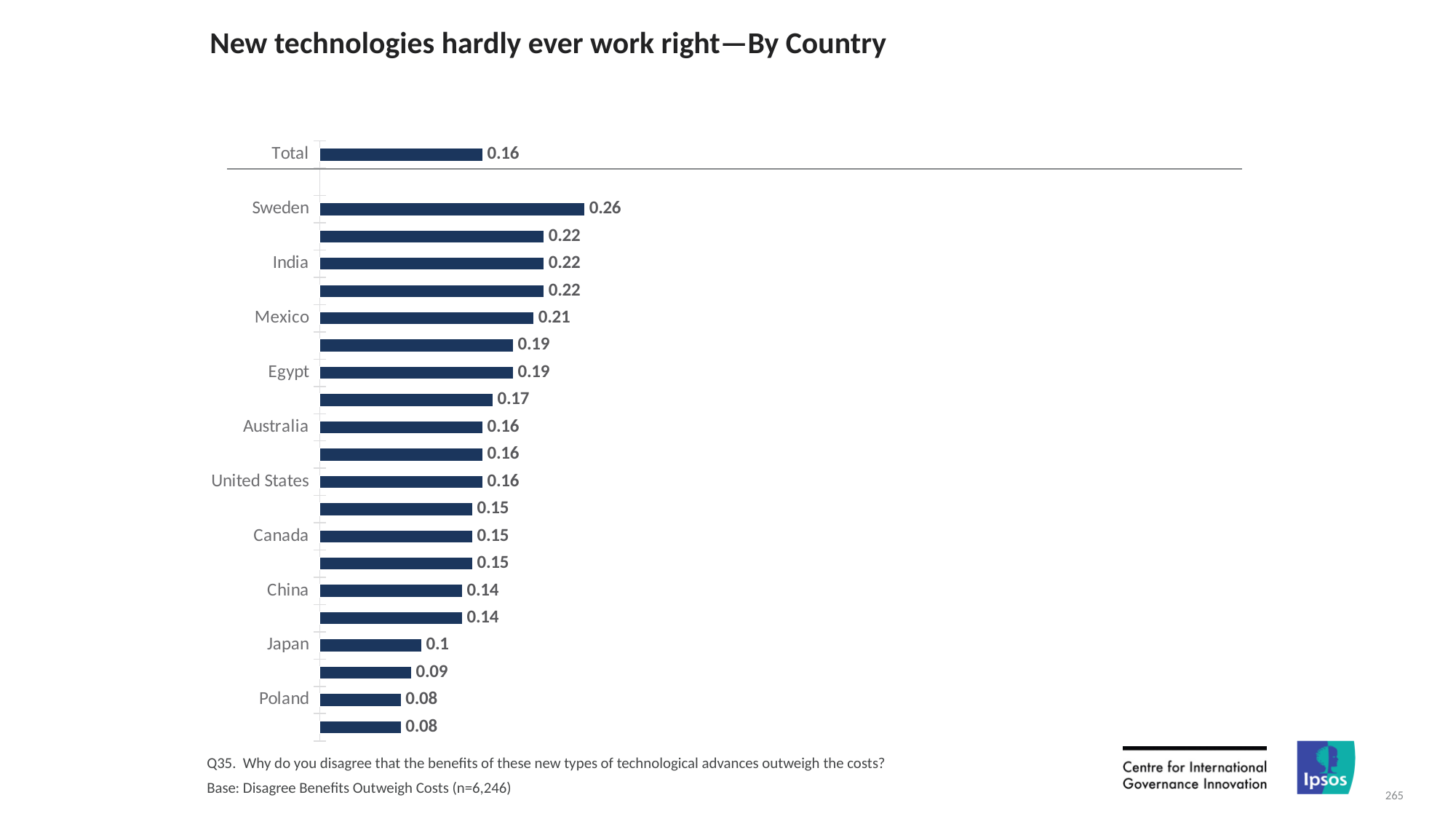
What is the value for Sweden? 0.26 What is the value for Total? 0.16 What is the value for Poland? 0.08 What is the difference between the values for Mexico and Japan? 0.11 What is the value for Mexico? 0.21 What is the title of the chart? New technologies hardly ever work right—By Country What is the difference between the values for Sweden and Poland? 0.18 Which country has the highest value? Sweden What kind of chart is shown on the slide? Bar chart What is the value for Japan? 0.1 Which has a larger value, Mexico or Egypt? Mexico Which has a larger value, China or Japan? China